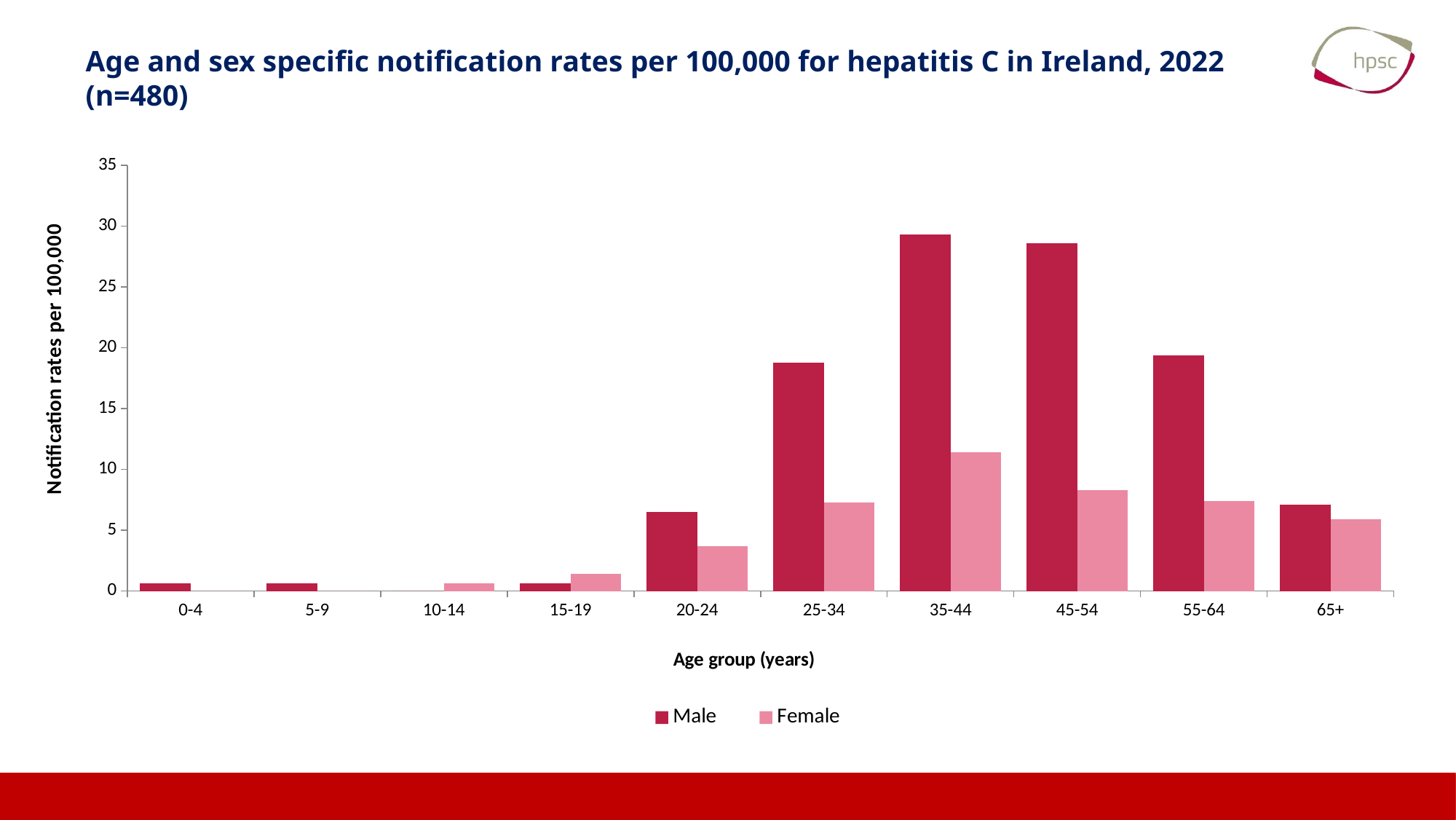
Is the Male notification rate for the 25-34 age group greater or less than 20? less Which is larger for the 55-64 age group, the Male or the Female notification rate? Male How many series does the legend list? 2 Is the Male notification rate for the 20-24 age group greater or less than 5? greater Is the Female notification rate for the 45-54 age group greater or less than 10? less How many age groups are shown on the x axis? 10 What is the label of the y axis? Notification rates per 100,000 Which is larger, the Male rate for 25-34 or the Male rate for 65+? Male rate for 25-34 What type of chart is shown on the slide? Bar chart Which age group has the highest Female notification rate? 35-44